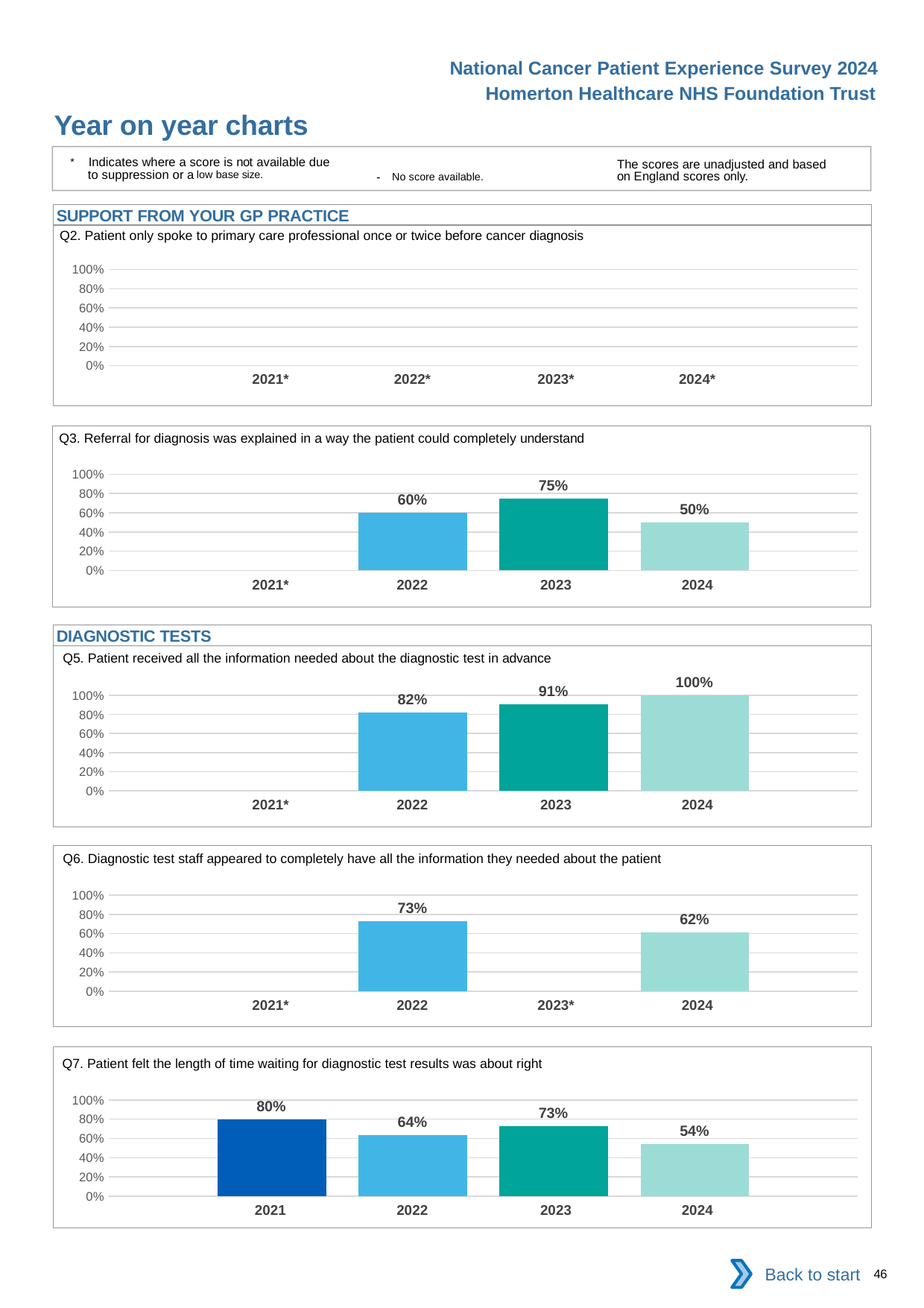
In the Q7 chart (Patient felt the length of time waiting for diagnostic test results was about right), which year has the highest value? 2021 In the Q6 chart, which is larger, the value for 2022 or the value for 2024? 2022 In the Q7 chart, what is the difference between the 2021 and 2024 values? 26 percentage points In the Q7 chart, how many years have a bar plotted? 4 In the Q2 chart (Patient only spoke to primary care professional once or twice before cancer diagnosis), how many years have a bar plotted? 0 In the Q3 chart (Referral for diagnosis was explained in a way the patient could completely understand), what is the value for 2023? 75% In the Q3 chart, which year has the lowest plotted value? 2024 In the Q5 chart, do the plotted values rise or fall from 2022 to 2024? rise In the Q5 chart, what is the difference between the 2023 and 2022 values? 9 percentage points In the Q6 chart (Diagnostic test staff appeared to completely have all the information they needed about the patient), what is the value for 2022? 73% In the Q5 chart (Patient received all the information needed about the diagnostic test in advance), what is the value for 2024? 100% What type of chart is the Q7 chart? bar chart